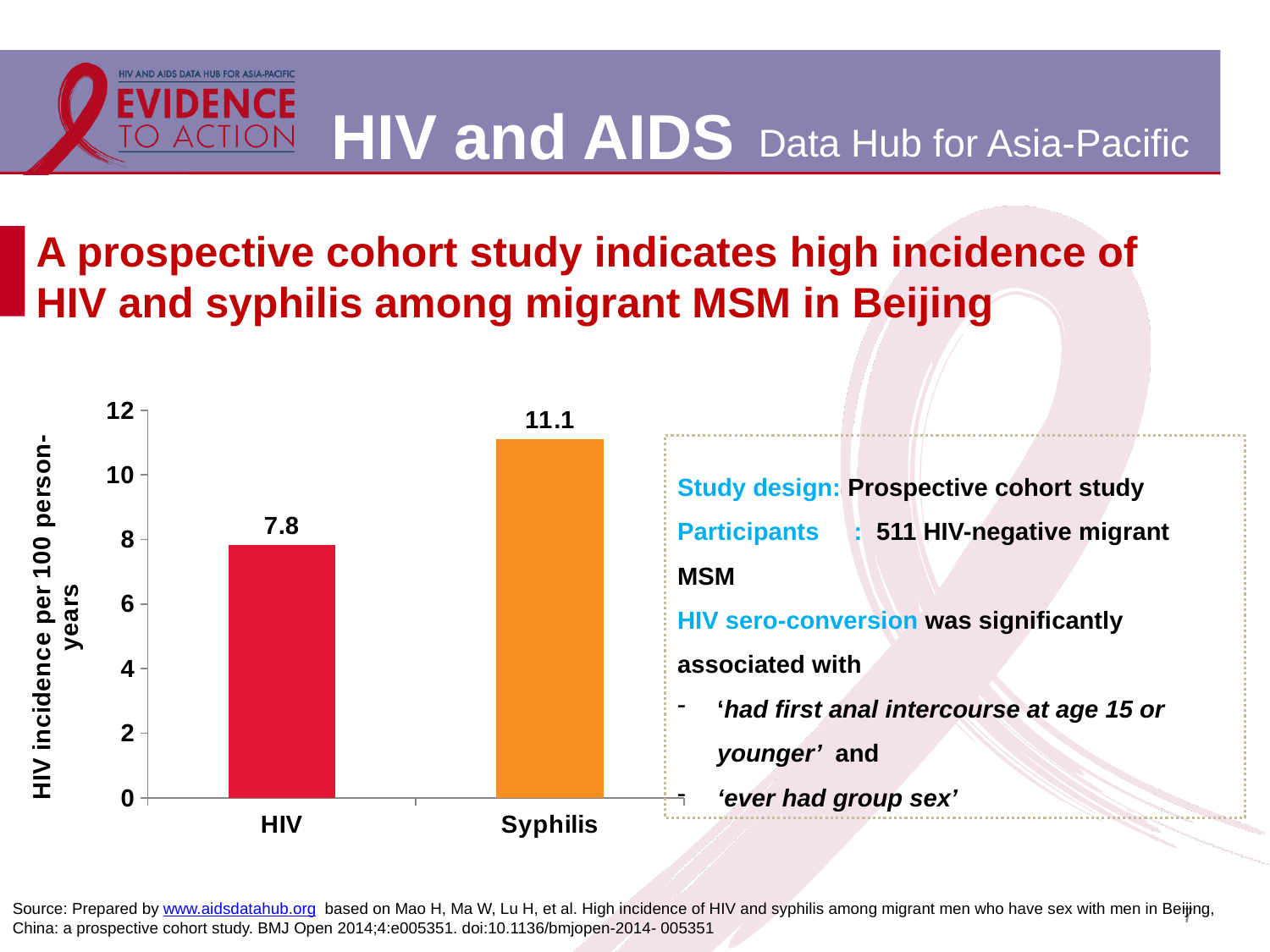
Is the value for Syphilis greater or less than 10? greater What is the value shown for Syphilis? 11.1 What kind of chart is shown on the slide? bar chart Which category has the higher value, HIV or Syphilis? Syphilis Which category has the lowest value? HIV Is the value for HIV larger or smaller than the value for Syphilis? smaller What is the label of the y axis? HIV incidence per 100 person-years What is the difference between the Syphilis value and the HIV value? 3.3 What colour is the Syphilis bar? orange What is the HIV incidence per 100 person-years shown for HIV? 7.8 How many categories are shown on the x axis? 2 Is the value for HIV greater or less than 8? less